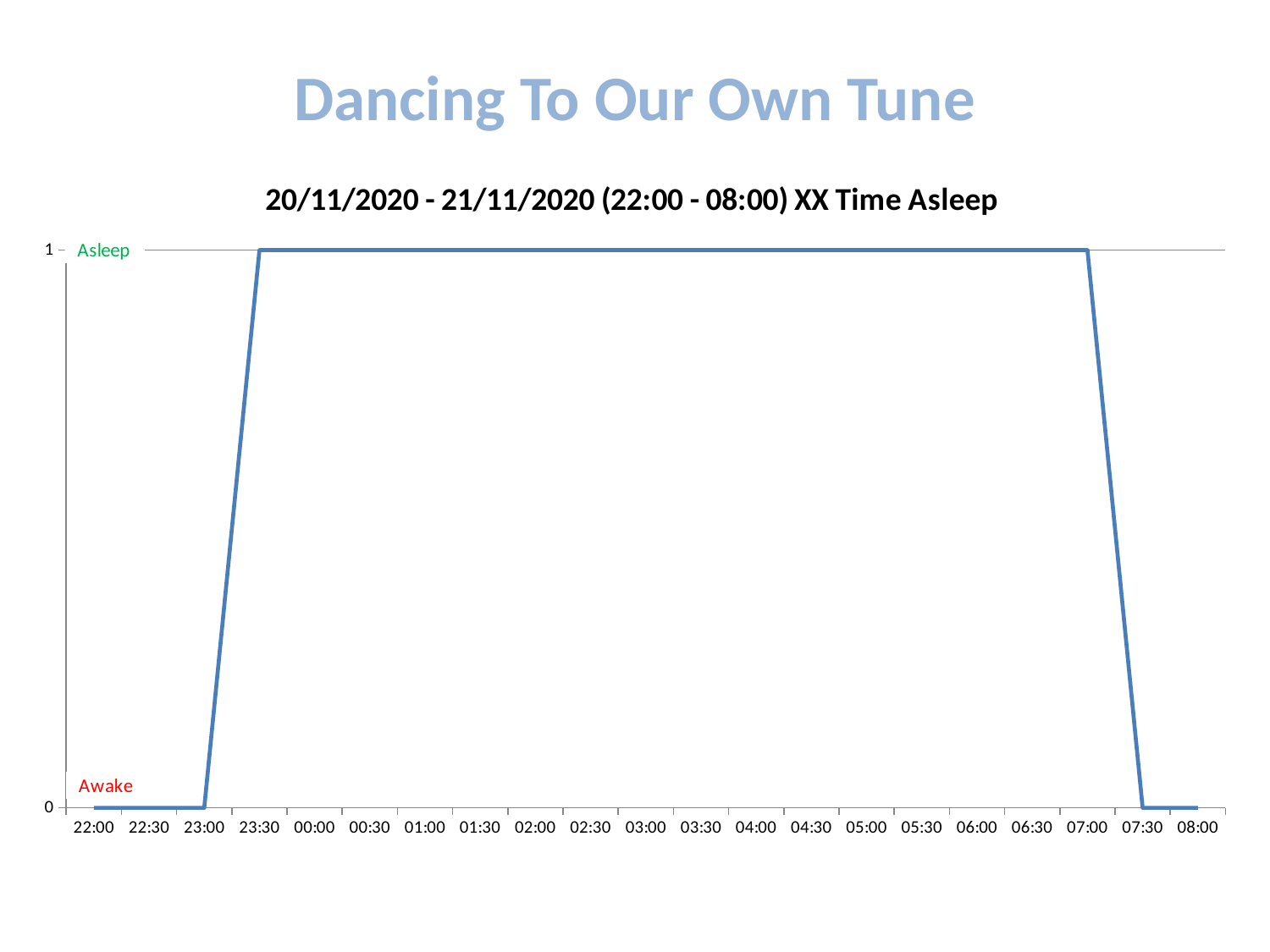
What is the plotted value at 07:30? 0 Which has the larger plotted value, 23:00 or 00:00? 00:00 What label is shown next to the value 1 on the y axis? Asleep What is the title of the chart? 20/11/2020 - 21/11/2020 (22:00 - 08:00) XX Time Asleep What is the difference between the plotted value at 03:00 and the plotted value at 22:30? 1 What kind of chart is shown on the slide? line chart What is the plotted value at 23:30? 1 How many time points are labelled along the x axis? 21 Does the line rise or fall between 07:00 and 07:30? falls Does the line rise or fall between 23:00 and 23:30? rises What is the plotted value at 07:00? 1 What is the plotted value at 22:00? 0